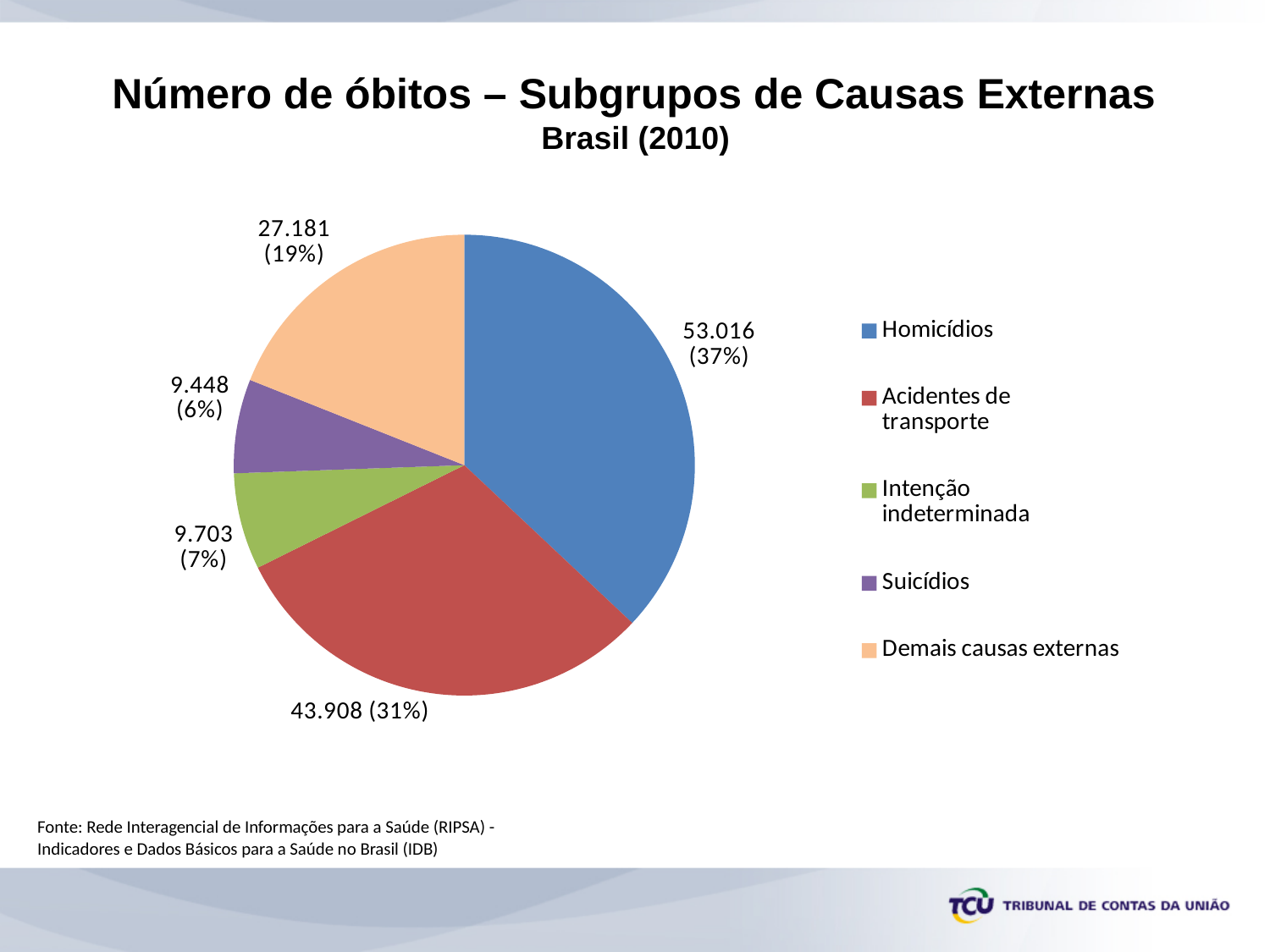
Which category has the largest slice? Homicídios Which is larger, the value for Demais causas externas or the value for Suicídios? Demais causas externas What is the number of deaths for Acidentes de transporte? 43.908 What is the difference between the values for Homicídios and Acidentes de transporte? 9.108 What is the number of deaths for Demais causas externas? 27.181 What is the number of deaths for Suicídios? 9.448 How many slices does the pie chart have? 5 What type of chart is shown on the slide? pie chart Which category has the smallest slice? Suicídios What share of the pie does Intenção indeterminada represent? 7% What is the number of deaths for Homicídios? 53.016 How many entries does the legend list? 5